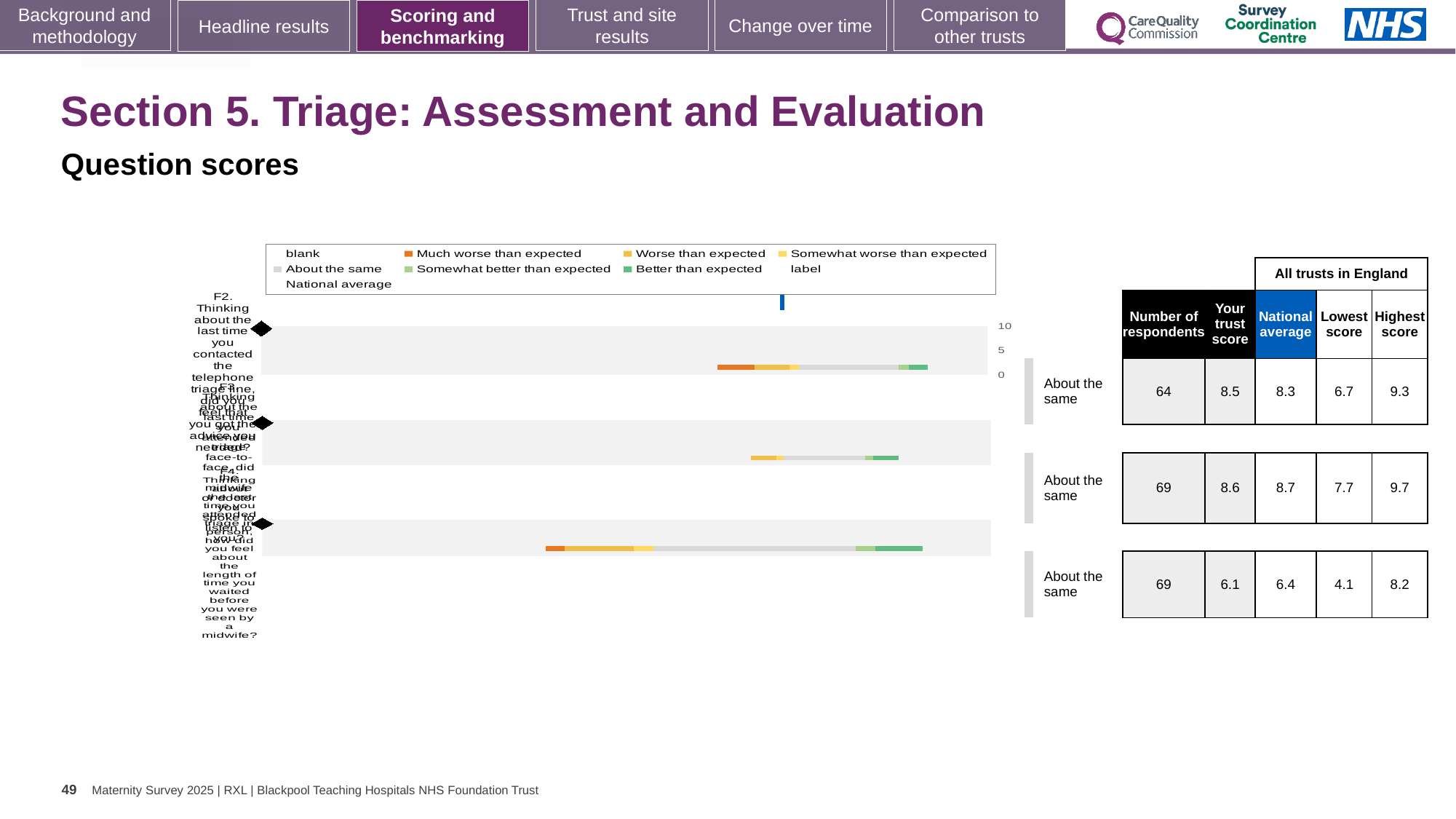
What kind of chart is shown on the slide? bar chart In the table beside the chart, what is the benchmark category shown for all three rows? About the same In the table beside the chart, what is the national average for the third row (F4)? 6.4 In the table beside the chart, what is the difference between the highest score and lowest score for the third row (F4)? 4.1 In the table beside the chart, which row has the lowest trust score? F4 (third row) In the table beside the chart, which row has the highest 'Highest score' value? F3 (second row) In the table beside the chart, is the trust score for the first row (F2) larger or smaller than its national average? larger In the table beside the chart, what is the number of respondents for the second row (F3)? 69 Which legend entry is shown in dark orange? Much worse than expected How many question rows (categories) does the chart plot? 3 In the table beside the chart, what is the trust score for the first row (F2)? 8.5 Which legend entry is shown in dark green? Better than expected